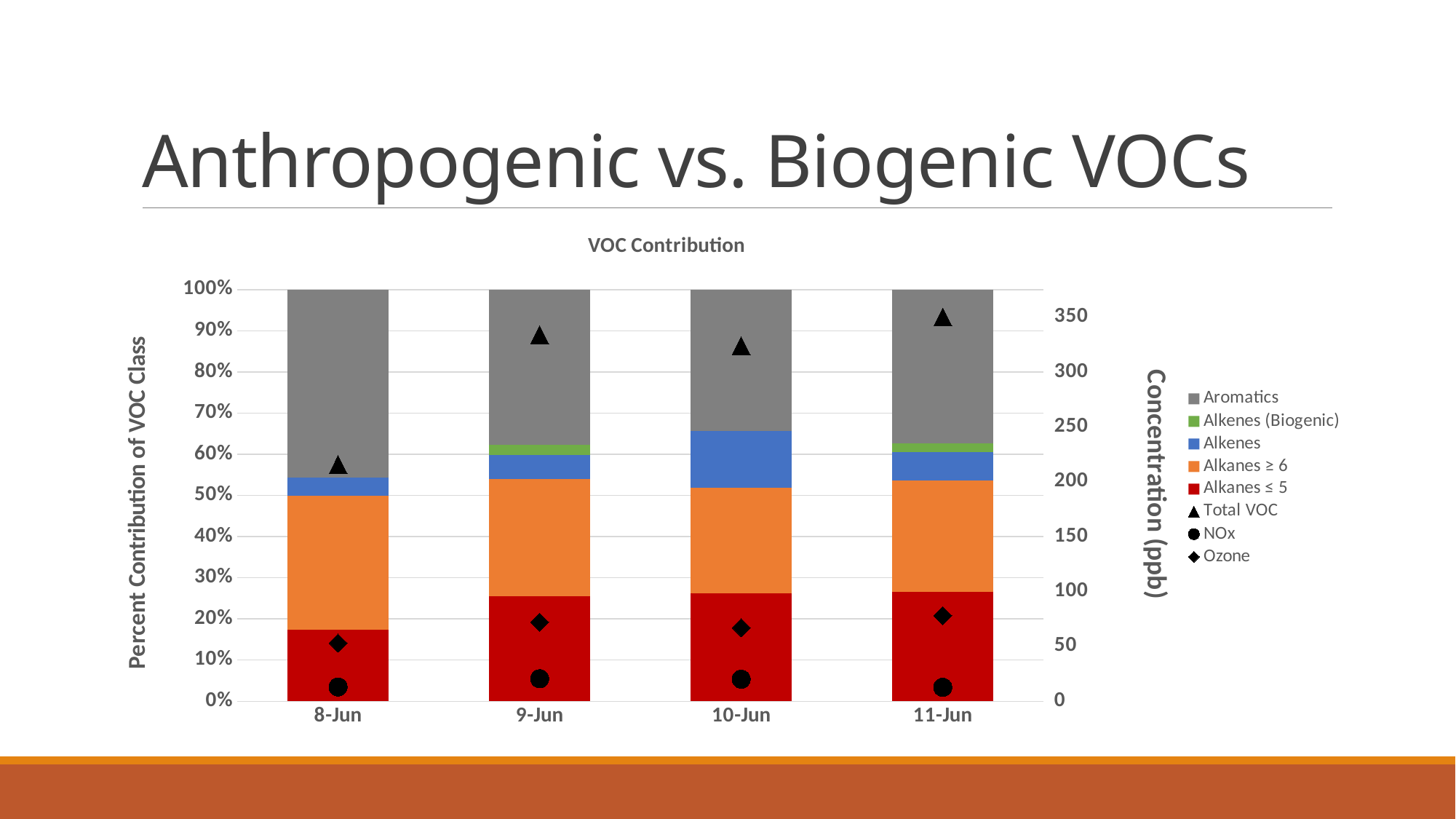
On which date is the Total VOC concentration highest? 11-Jun On which date is the Total VOC concentration lowest? 8-Jun Is the Ozone concentration on 8-Jun greater or less than 100 ppb? less Is the Total VOC concentration on 11-Jun greater or less than 300 ppb? greater What kind of chart is used for the VOC class contributions? Stacked bar chart What is the title of the chart? VOC Contribution What is the label of the right-hand (secondary) vertical axis? Concentration (ppb) Which date has the lowest Ozone concentration? 8-Jun How many series does the chart's legend list? 8 How many dates are shown on the x axis of the chart? 4 Is the Total VOC concentration on 8-Jun greater or less than 250 ppb? less